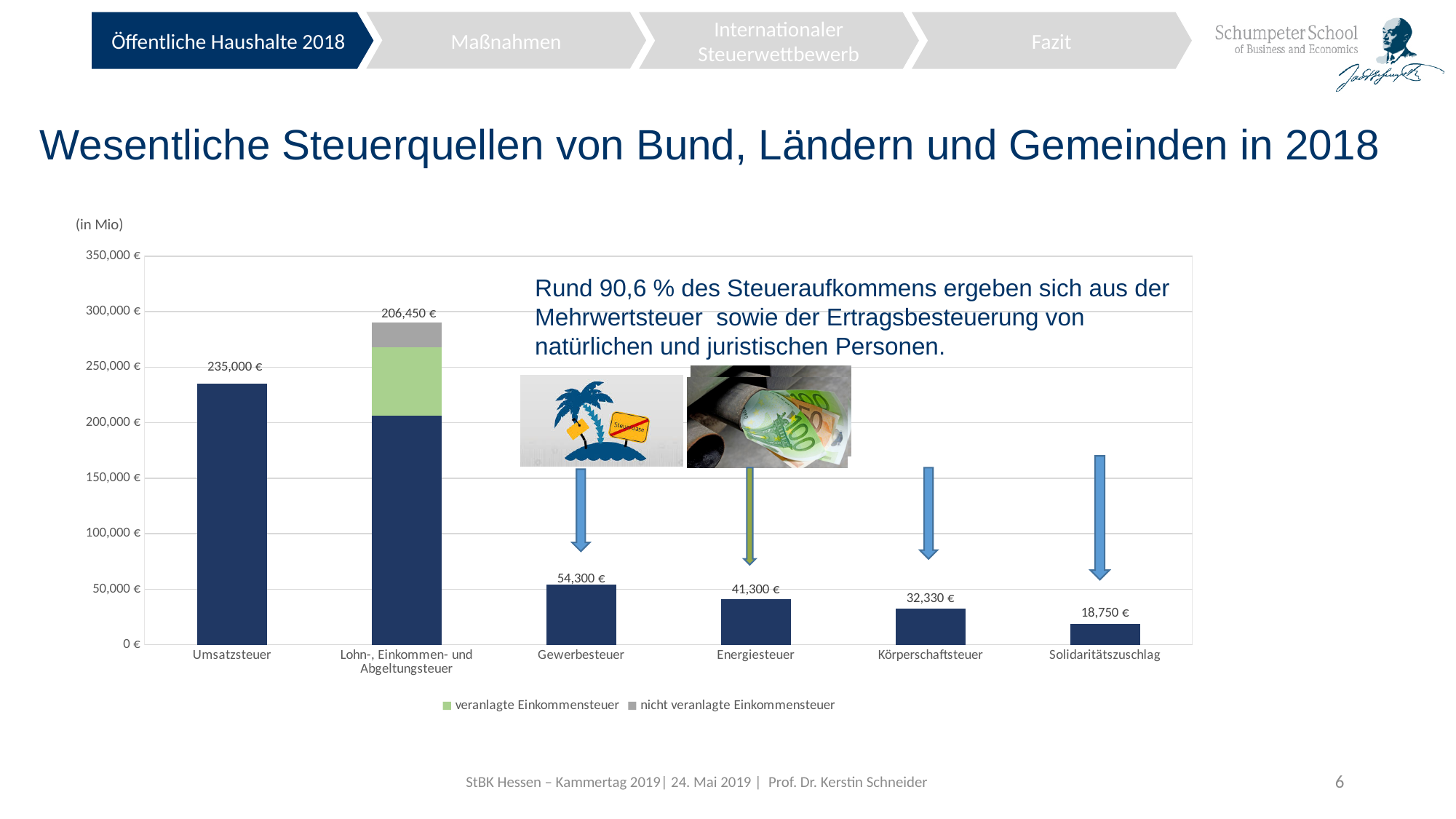
What is the difference between the values for Gewerbesteuer and Energiesteuer? 13,000 € Which is larger, the value for Körperschaftsteuer or the value for Solidaritätszuschlag? Körperschaftsteuer How many categories are shown on the x axis? 6 How many series does the legend list? 2 What is the value shown for Körperschaftsteuer? 32,330 € What is the value shown for Umsatzsteuer? 235,000 € Which category has the lowest value? Solidaritätszuschlag What is the value shown for Solidaritätszuschlag? 18,750 € Is the value for Umsatzsteuer greater or less than 200,000 €? greater What is the value shown for Gewerbesteuer? 54,300 € What kind of chart is shown on the slide? bar chart What is the value shown for Energiesteuer? 41,300 €